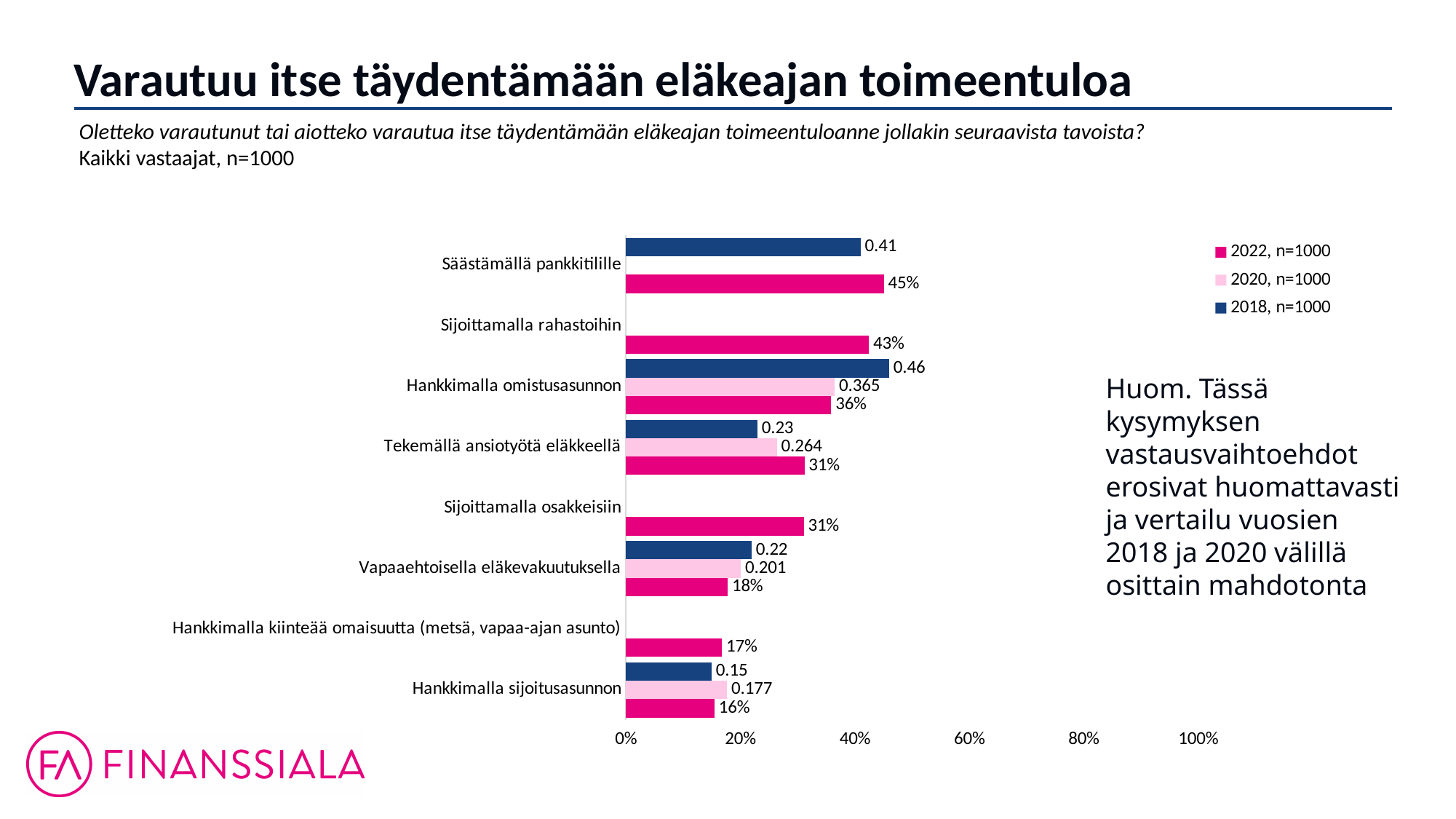
Which is larger for Hankkimalla omistusasunnon: the 2018 value or the 2022 value? 2018 What kind of chart is shown on the slide? Bar chart Is the 2022 value for Sijoittamalla osakkeisiin greater or less than 40%? less What is the 2022 value for Vapaaehtoisella eläkevakuutuksella? 18% What is the 2022 value for Säästämällä pankkitilille? 45% What is the 2018 value for Hankkimalla omistusasunnon? 0.46 Which category has the highest 2022 value? Säästämällä pankkitilille Which category has the lowest 2022 value? Hankkimalla sijoitusasunnon How many series does the legend list? 3 How many categories are shown on the chart? 8 What is the difference between the 2022 values for Säästämällä pankkitilille and Sijoittamalla rahastoihin? 2% What is the 2020 value for Tekemällä ansiotyötä eläkkeellä? 0.264